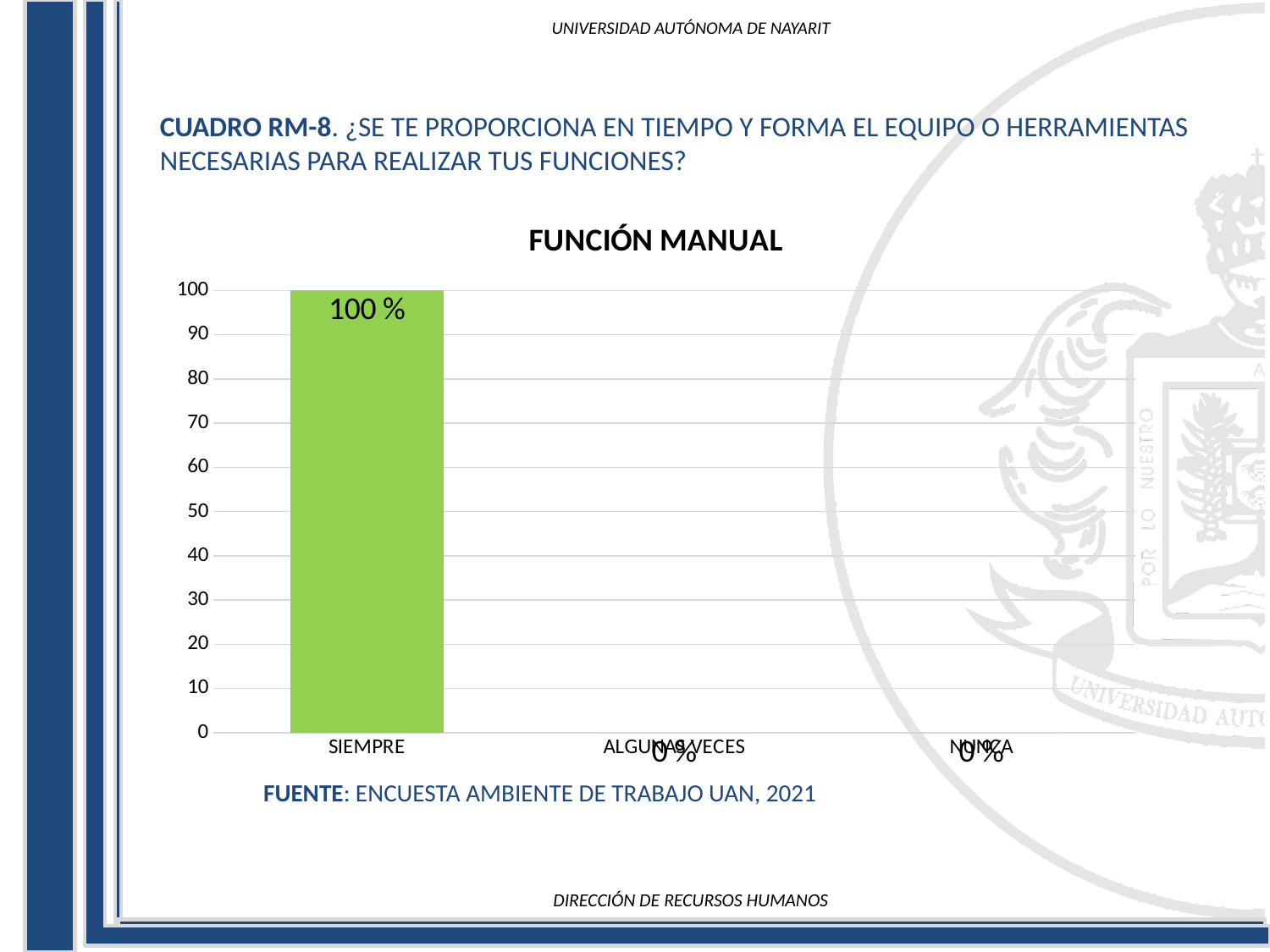
What is the value for SIEMPRE? 100 % What kind of chart is shown? bar chart What colour is the bar for SIEMPRE? green What is the title of the chart? FUNCIÓN MANUAL Which category has the highest value? SIEMPRE What is the value for ALGUNAS VECES? 0 % What is the value for NUNCA? 0 % What is the difference between the values for SIEMPRE and NUNCA? 100 % How many categories are shown on the x axis? 3 Is the value for SIEMPRE greater or less than 50? greater Do the values rise or fall from SIEMPRE to NUNCA along the x axis? fall Which is larger, the value for SIEMPRE or the value for ALGUNAS VECES? SIEMPRE